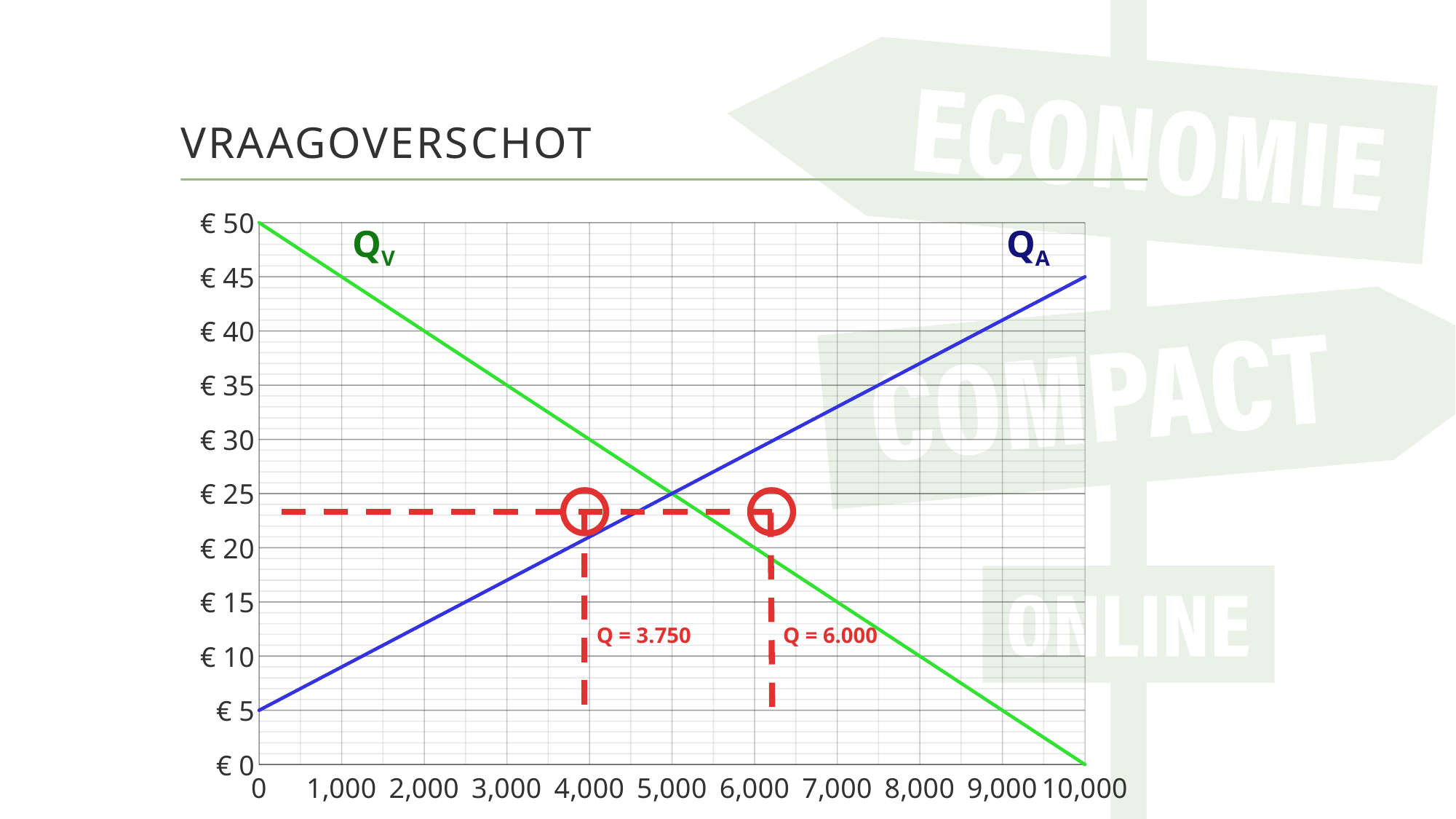
What is the title of the chart? VRAAGOVERSCHOT What is the difference between the Q_V price and the Q_A price at a quantity of 0? € 45 Does the Q_V line rise or fall as quantity increases? fall What is the price on the Q_V line at a quantity of 10,000? € 0 How many lines are plotted on the chart? 2 At a quantity of 2,000, which line shows the higher price, Q_V or Q_A? Q_V What kind of chart is shown on the slide? line chart Is the price on the Q_A line at a quantity of 4,000 greater or less than € 25? less What is the price on the Q_A line at a quantity of 10,000? € 45 What is the price on the Q_V line at a quantity of 0? € 50 Does the Q_A line rise or fall as quantity increases? rise What is the price on the Q_A line at a quantity of 0? € 5